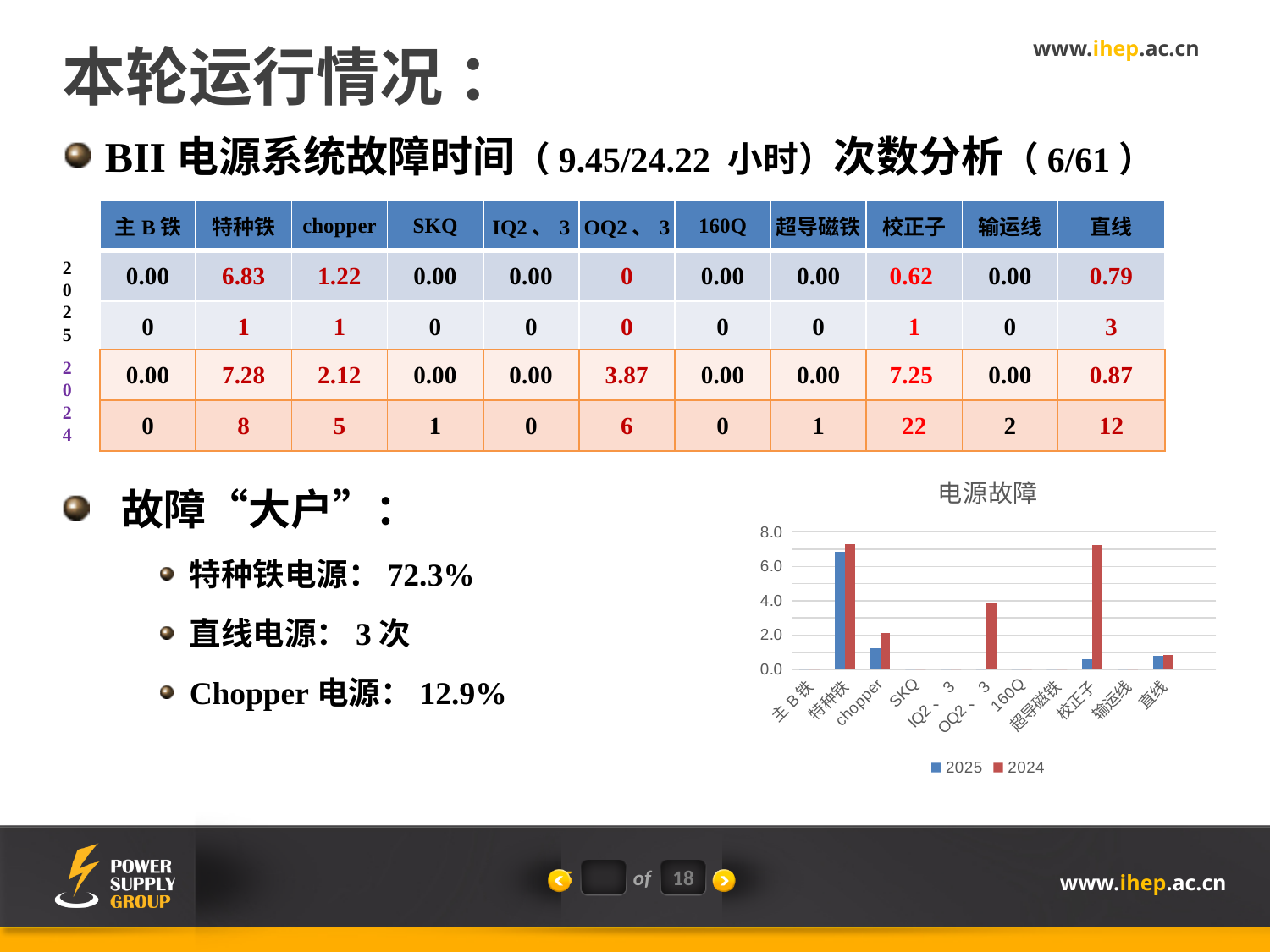
How many categories are shown on the x axis of the 电源故障 chart? 11 In the 电源故障 chart, is the 2025 value for 特种铁 greater or less than 6.0? greater In the 电源故障 chart, is the 2024 value for 校正子 greater or less than 6.0? greater In the 电源故障 chart, for chopper, which series has the larger value, 2025 or 2024? 2024 In the 电源故障 chart, for 校正子, which series has the larger value, 2025 or 2024? 2024 In the 电源故障 chart, is the 2024 value for OQ2、3 greater or less than 2.0? greater What kind of chart is the 电源故障 chart? bar chart In the 电源故障 chart, which category has the highest value for the 2025 series? 特种铁 What is the title of the chart on the slide? 电源故障 How many series does the legend of the 电源故障 chart list? 2